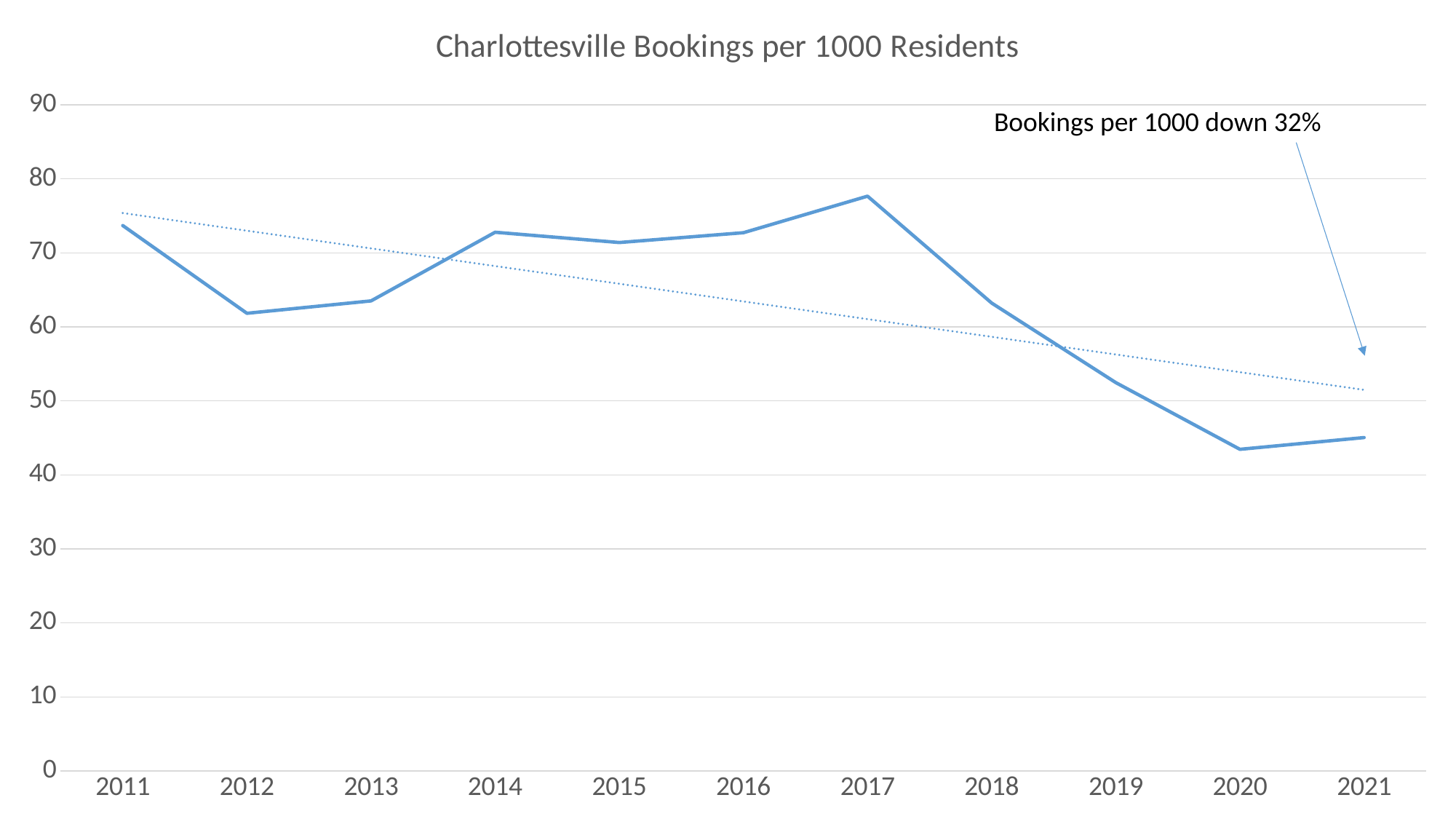
Overall, do bookings per 1000 residents rise or fall from 2011 to 2021? Fall Is the value for 2012 greater or less than 60? greater Is the value for 2017 greater or less than 70? greater What does the text annotation on the chart say? Bookings per 1000 down 32% Is the value for 2011 greater or less than 70? greater How many years are plotted along the x axis? 11 What kind of chart is shown on the slide? Line chart Which year has the larger value, 2011 or 2012? 2011 Which year has the highest bookings per 1000 residents? 2017 What is the title of the chart? Charlottesville Bookings per 1000 Residents